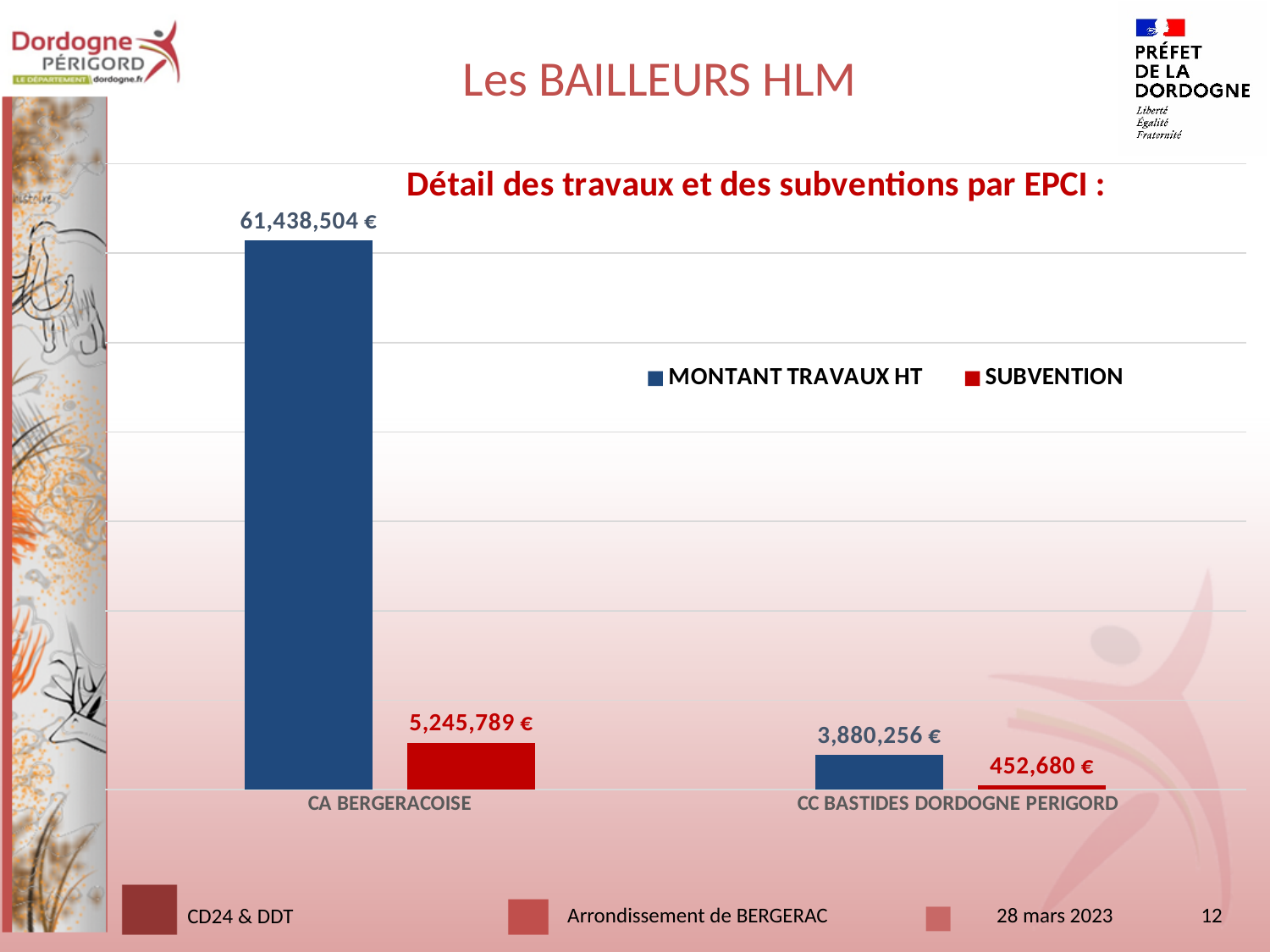
What is the difference between MONTANT TRAVAUX HT and SUBVENTION for CA BERGERACOISE? 56,192,715 € What is the difference between MONTANT TRAVAUX HT and SUBVENTION for CC BASTIDES DORDOGNE PERIGORD? 3,427,576 € What is the SUBVENTION value for CA BERGERACOISE? 5,245,789 € How many series does the legend list? 2 What kind of chart is shown on the slide? Bar chart Which EPCI has the highest MONTANT TRAVAUX HT? CA BERGERACOISE What is the SUBVENTION value for CC BASTIDES DORDOGNE PERIGORD? 452,680 € Which is larger: the SUBVENTION for CA BERGERACOISE or the MONTANT TRAVAUX HT for CC BASTIDES DORDOGNE PERIGORD? SUBVENTION for CA BERGERACOISE What is the MONTANT TRAVAUX HT value for CC BASTIDES DORDOGNE PERIGORD? 3,880,256 € How many EPCI categories are shown on the chart? 2 Which EPCI has the lowest SUBVENTION? CC BASTIDES DORDOGNE PERIGORD What is the MONTANT TRAVAUX HT value for CA BERGERACOISE? 61,438,504 €